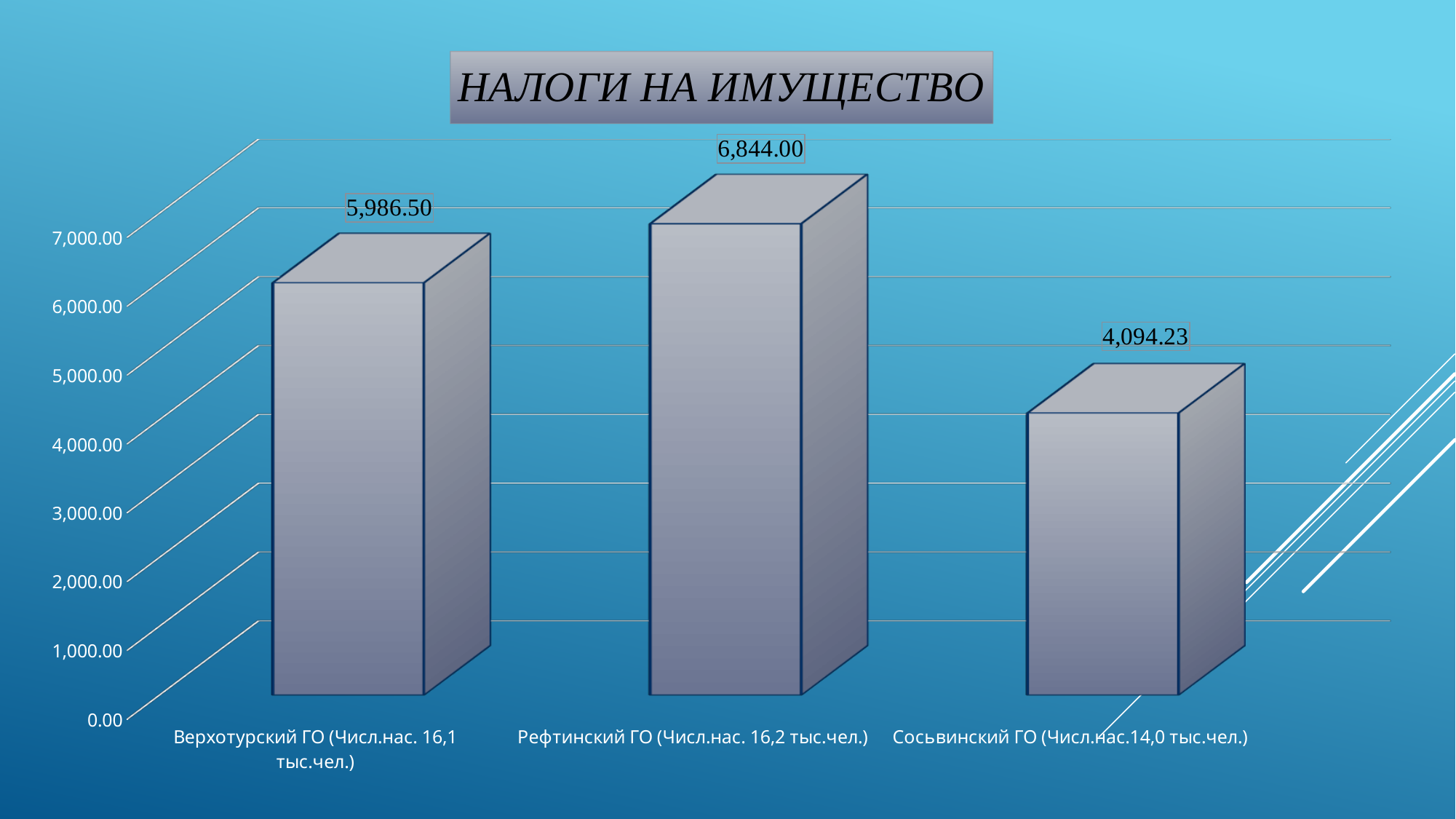
Which category has the highest value? Рефтинский ГО What is the difference between the values for Верхотурский ГО and Сосьвинский ГО? 1,892.27 What is the value for Сосьвинский ГО? 4,094.23 What is the difference between the values for Рефтинский ГО and Верхотурский ГО? 857.50 What is the title of the chart? НАЛОГИ НА ИМУЩЕСТВО What is the value for Рефтинский ГО? 6,844.00 Which is larger, the value for Верхотурский ГО or the value for Сосьвинский ГО? Верхотурский ГО Is the value for Сосьвинский ГО greater or less than 5,000.00? less Which category has the lowest value? Сосьвинский ГО What is the value for Верхотурский ГО? 5,986.50 What kind of chart is shown on the slide? bar chart How many categories are shown in the chart? 3